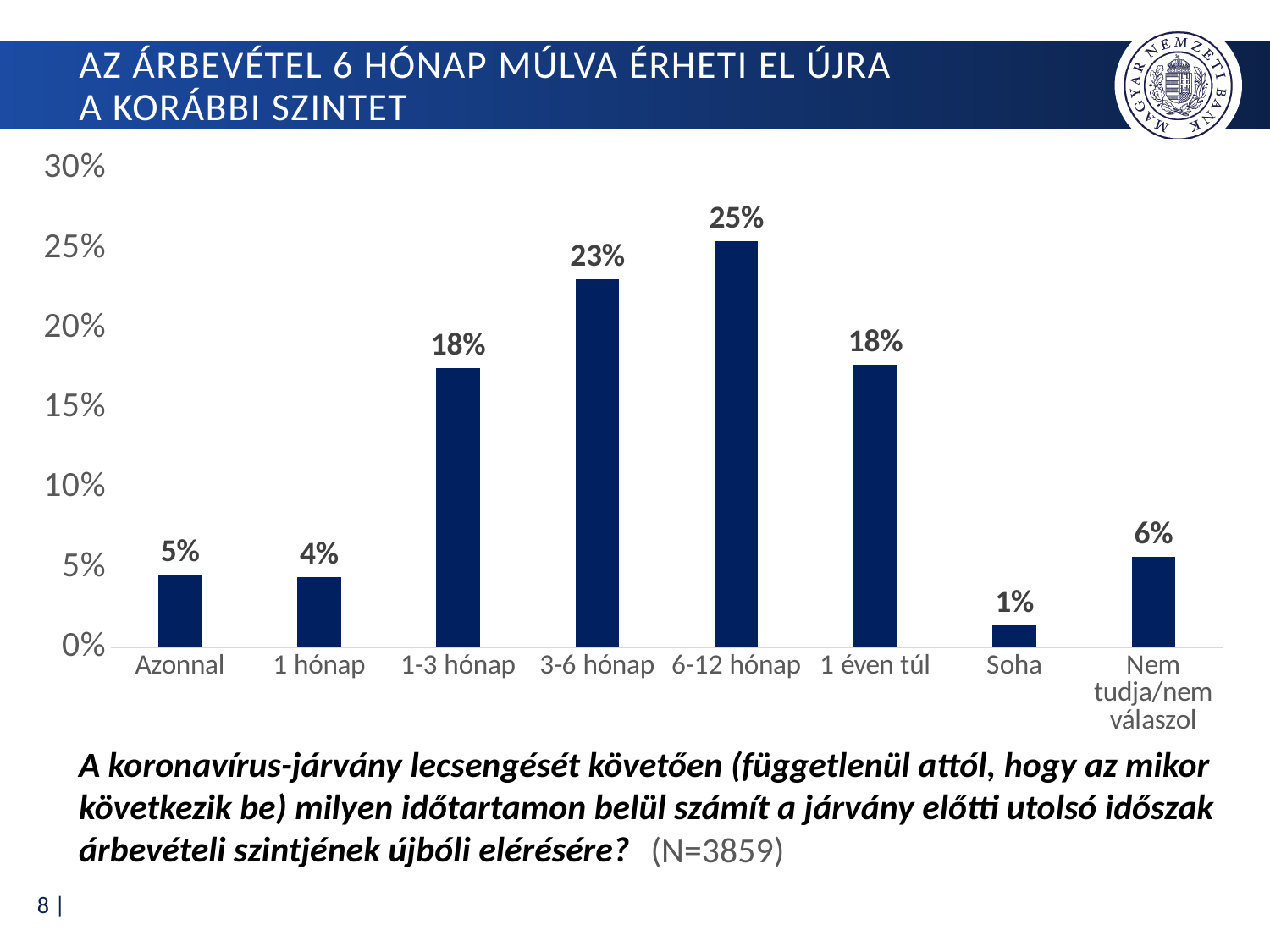
Which is larger, the value for "1-3 hónap" or the value for "3-6 hónap"? 3-6 hónap Which category has the highest value? 6-12 hónap What is the value for the "Nem tudja/nem válaszol" category? 6% What is the sample size (N) stated below the chart? N=3859 What is the difference between the values for "Azonnal" and "1 hónap"? 1% What kind of chart is shown on the slide? bar chart Which category has the lowest value? Soha How many categories are shown on the x axis? 8 What is the value for the "Azonnal" category? 5% What is the difference between the values for "6-12 hónap" and "3-6 hónap"? 2% Is the value for "1 éven túl" greater or less than 20%? less What is the value for the "6-12 hónap" category? 25%